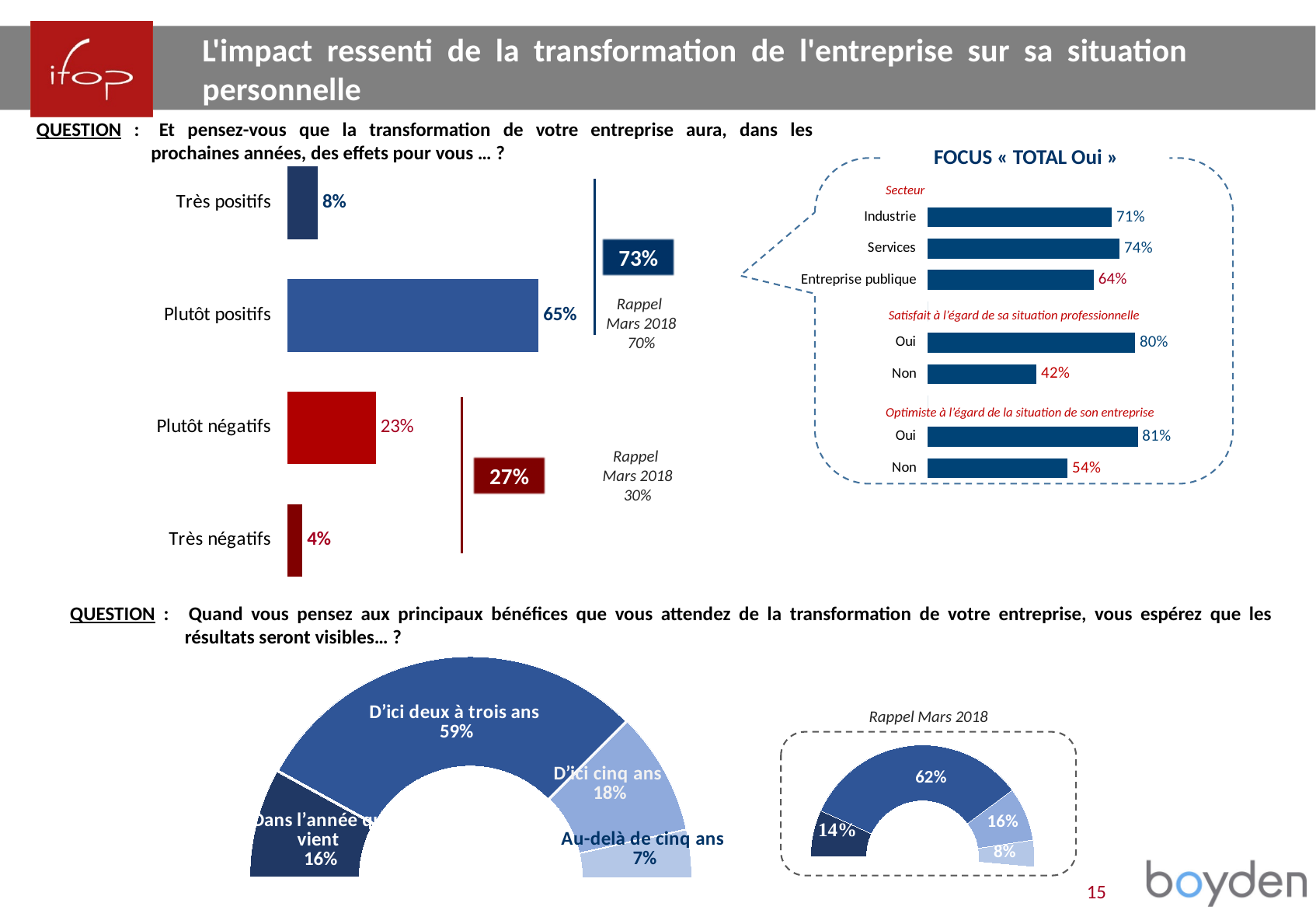
In the bottom-left half-donut chart, which category has the smallest share? Au-delà de cinq ans In the top-left bar chart, what percentage answered "Très négatifs"? 4% In the top-left bar chart, how many response categories are shown? 4 In the "FOCUS « TOTAL Oui »" chart, which sector has the lowest value? Entreprise publique In the "FOCUS « TOTAL Oui »" chart, what is the difference between "Oui" and "Non" for those satisfied with their professional situation? 38 percentage points In the top-left bar chart, which response category has the highest value? Plutôt positifs In the top-left bar chart, what is the difference between "Plutôt négatifs" and "Très positifs"? 15 percentage points In the bottom-left half-donut chart, what share of respondents chose "D'ici deux à trois ans"? 59% In the top-left bar chart on the impact of the company's transformation, what percentage of respondents answered "Plutôt positifs"? 65% In the "Rappel Mars 2018" half-donut chart at the bottom right, what is the largest value shown? 62% In the "FOCUS « TOTAL Oui »" chart, what is the value for "Services"? 74% In the "FOCUS « TOTAL Oui »" chart, which is larger: "Oui" for optimistic about the company's situation, or "Industrie"? Oui (optimiste), 81%